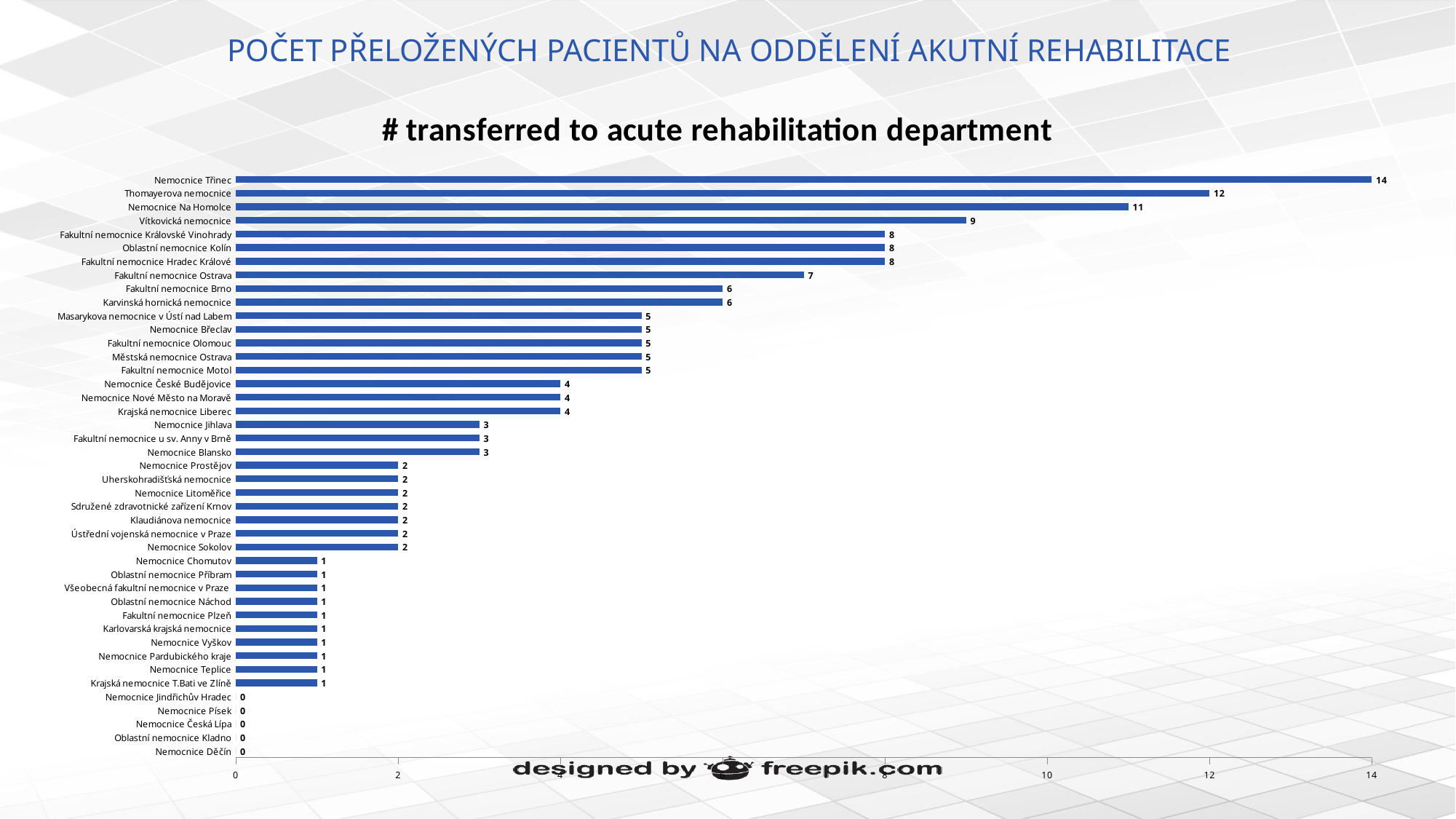
What is the value for Fakultní nemocnice Motol? 5 What is the title of the chart? # transferred to acute rehabilitation department What is the difference between the values for Nemocnice Třinec and Fakultní nemocnice Ostrava? 7 What is the value for Nemocnice Třinec? 14 What is the difference between the values for Thomayerova nemocnice and Nemocnice Na Homolce? 1 What is the value for Vítkovická nemocnice? 9 Which hospital has the highest number of patients transferred to the acute rehabilitation department? Nemocnice Třinec Which is larger, the value for Fakultní nemocnice Brno or the value for Krajská nemocnice Liberec? Fakultní nemocnice Brno Is the value for Nemocnice Na Homolce greater or less than 10? greater How many hospitals have a value of 0? 5 What kind of chart is shown on the slide? bar chart What is the value for Nemocnice Blansko? 3